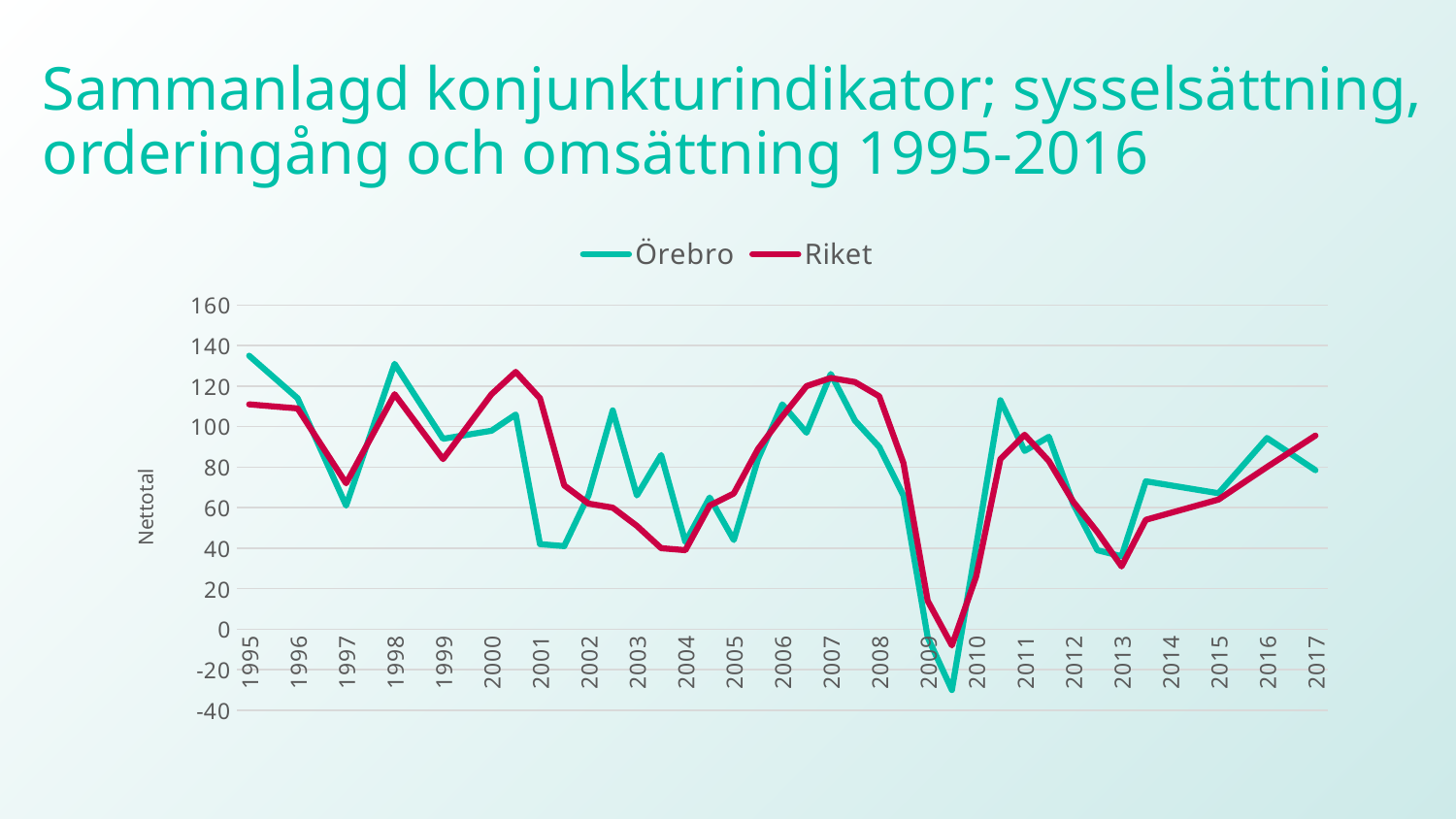
In 1995, which series has the higher value, Örebro or Riket? Örebro In 2017, which series has the higher value, Örebro or Riket? Riket What are the two series named in the legend? Örebro and Riket How many series does the legend list? 2 Is the value for Örebro in 1995 greater or less than 120? greater Does the Riket line rise or fall between 2013 and 2017? rise Is the value for Riket in 2013 greater or less than 40? less How many year labels are shown on the x axis? 23 Is the lowest value of the Örebro line greater or less than -20? less What kind of chart is shown on the slide? line chart What is the label on the vertical axis? Nettotal